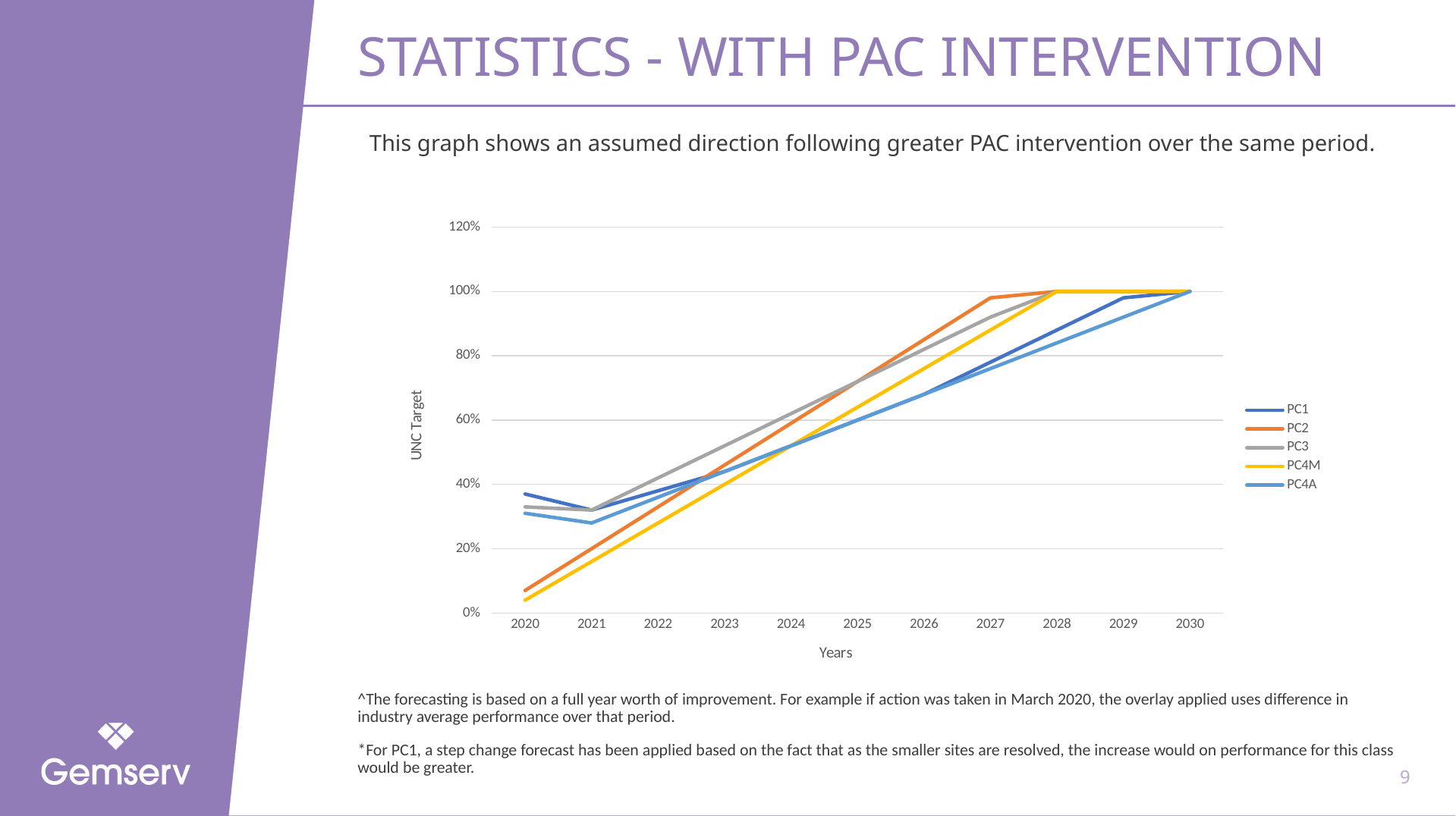
What is the value for PC2 in 2028? 100% What kind of chart is shown on the slide? line chart Is the value for PC2 in 2020 greater or less than 20%? less Is the value for PC3 in 2025 greater or less than 60%? greater What is the value for PC4M in 2030? 100% How many series does the legend list? 5 Do the values for PC2 rise or fall from 2020 to 2030? rise Is the value for PC4A in 2021 greater or less than 40%? less Which is larger in 2020, PC1 or PC2? PC1 Which series has the highest value in 2027? PC2 How many years are shown along the x axis? 11 What is the title of the y axis? UNC Target